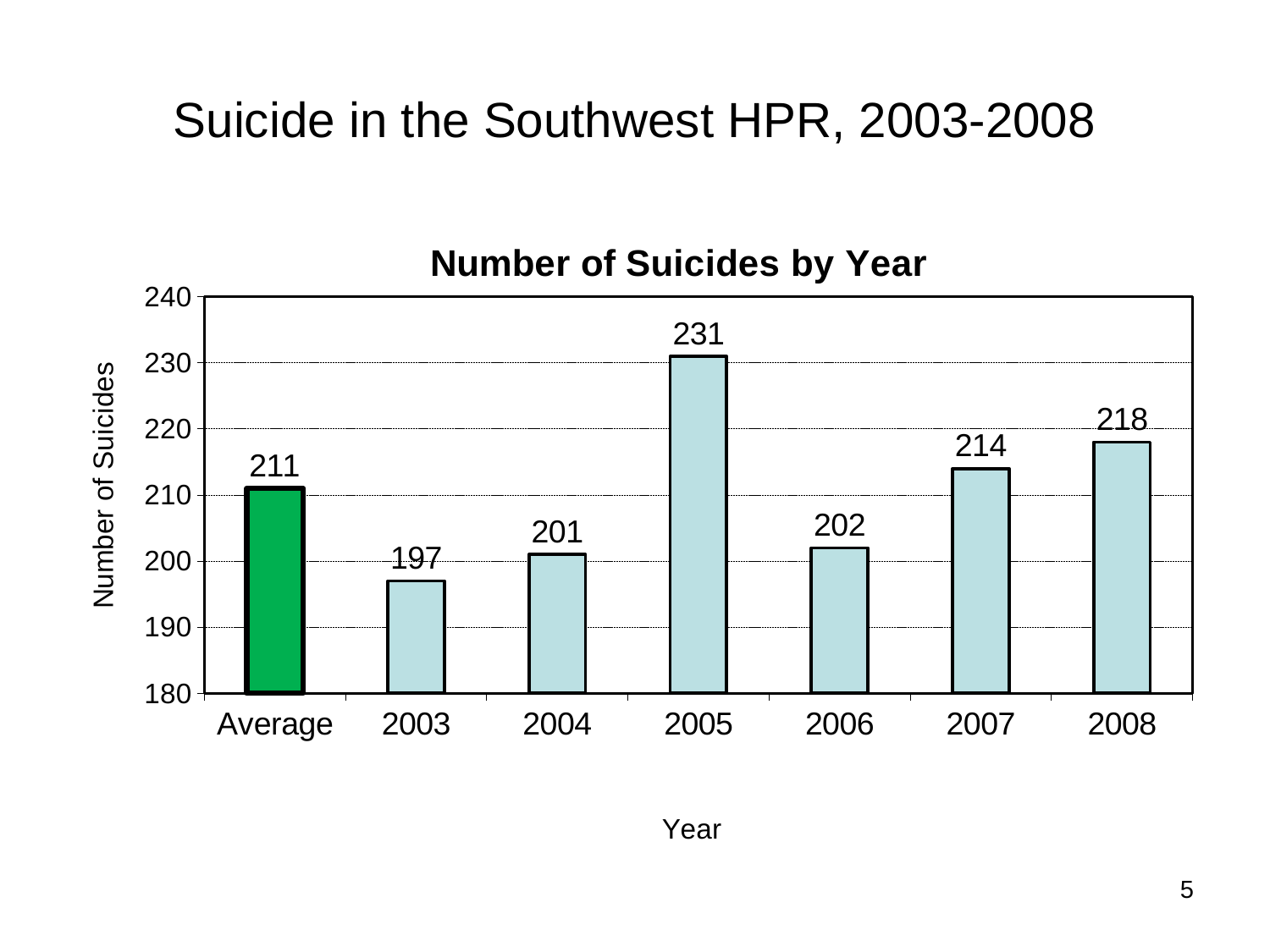
What is the number of suicides shown for 2003? 197 How many bars are shown in the chart? 7 What is the difference between the number of suicides in 2005 and 2003? 34 What is the number of suicides shown for 2005? 231 What is the title of the chart? Number of Suicides by Year What value is shown for the Average bar? 211 Which year has the highest number of suicides? 2005 What kind of chart is shown on the slide? bar chart Which is larger, the value for 2007 or the value for 2006? 2007 What is the difference between the 2008 value and the Average value? 7 Which year has the lowest number of suicides? 2003 Is the value for 2004 greater or less than 210? less